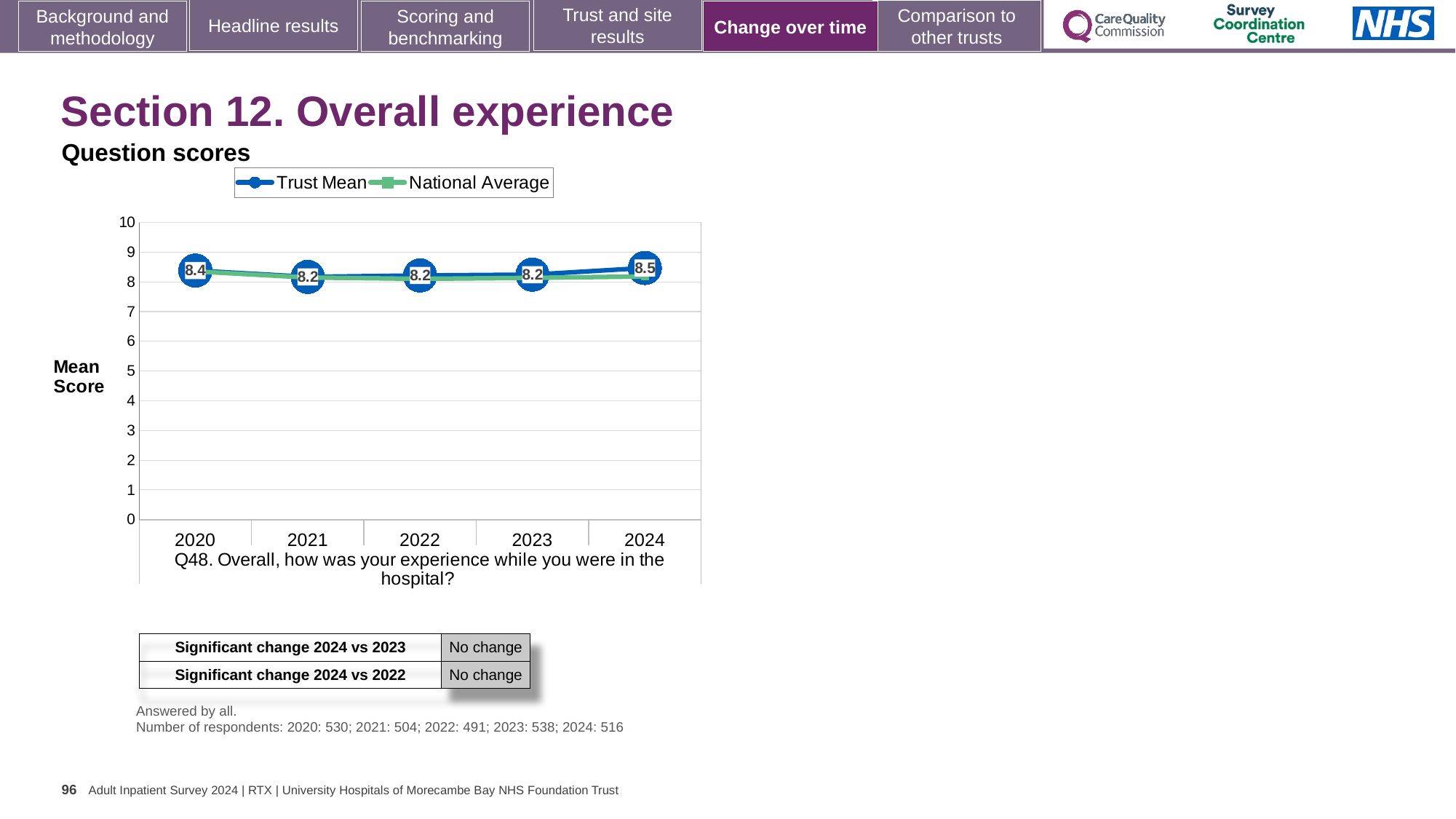
Is the National Average value for 2024 greater or less than 5? greater Which year has the larger Trust Mean score, 2021 or 2024? 2024 What is the Trust Mean score for 2022? 8.2 How many series does the legend list? 2 What kind of chart is shown? Line chart What is the difference between the Trust Mean scores for 2024 and 2023? 0.3 What is the Trust Mean score for 2020? 8.4 In which year is the Trust Mean score highest? 2024 Does the Trust Mean score rise or fall from 2023 to 2024? Rise What is the difference between the Trust Mean scores for 2024 and 2020? 0.1 How many years are plotted on the x axis? 5 What is the Trust Mean score for 2024? 8.5